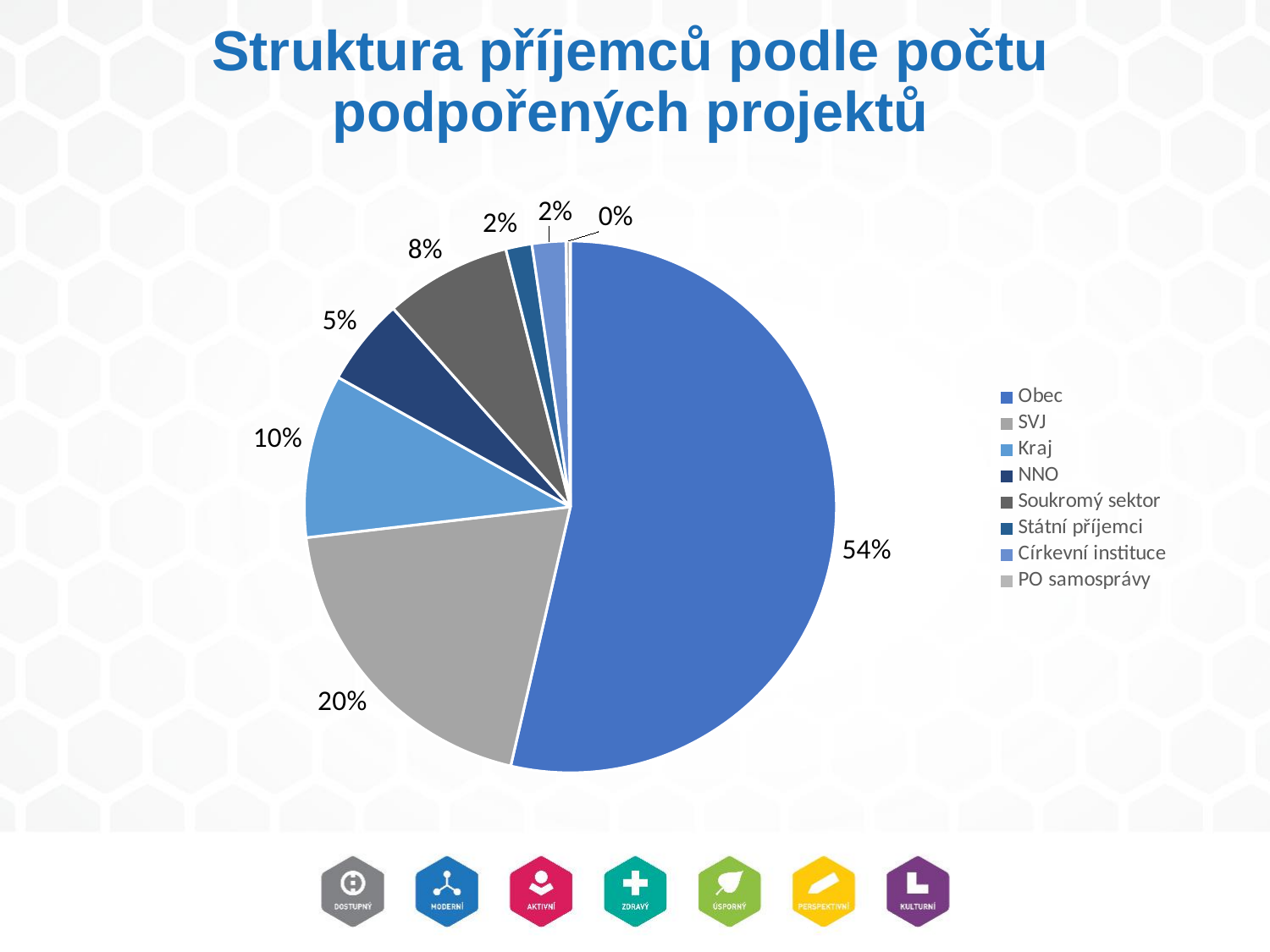
What share of the pie does Kraj hold? 10% What share of the pie does NNO hold? 5% Which category has the largest share of the pie? Obec How many categories does the legend list? 8 What share of the pie does SVJ hold? 20% What kind of chart is shown on the slide? Pie chart Which has a larger share, Kraj or Soukromý sektor? Kraj What is the difference in percentage points between the shares of Obec and SVJ? 34 Which category has the smallest share of the pie? PO samosprávy